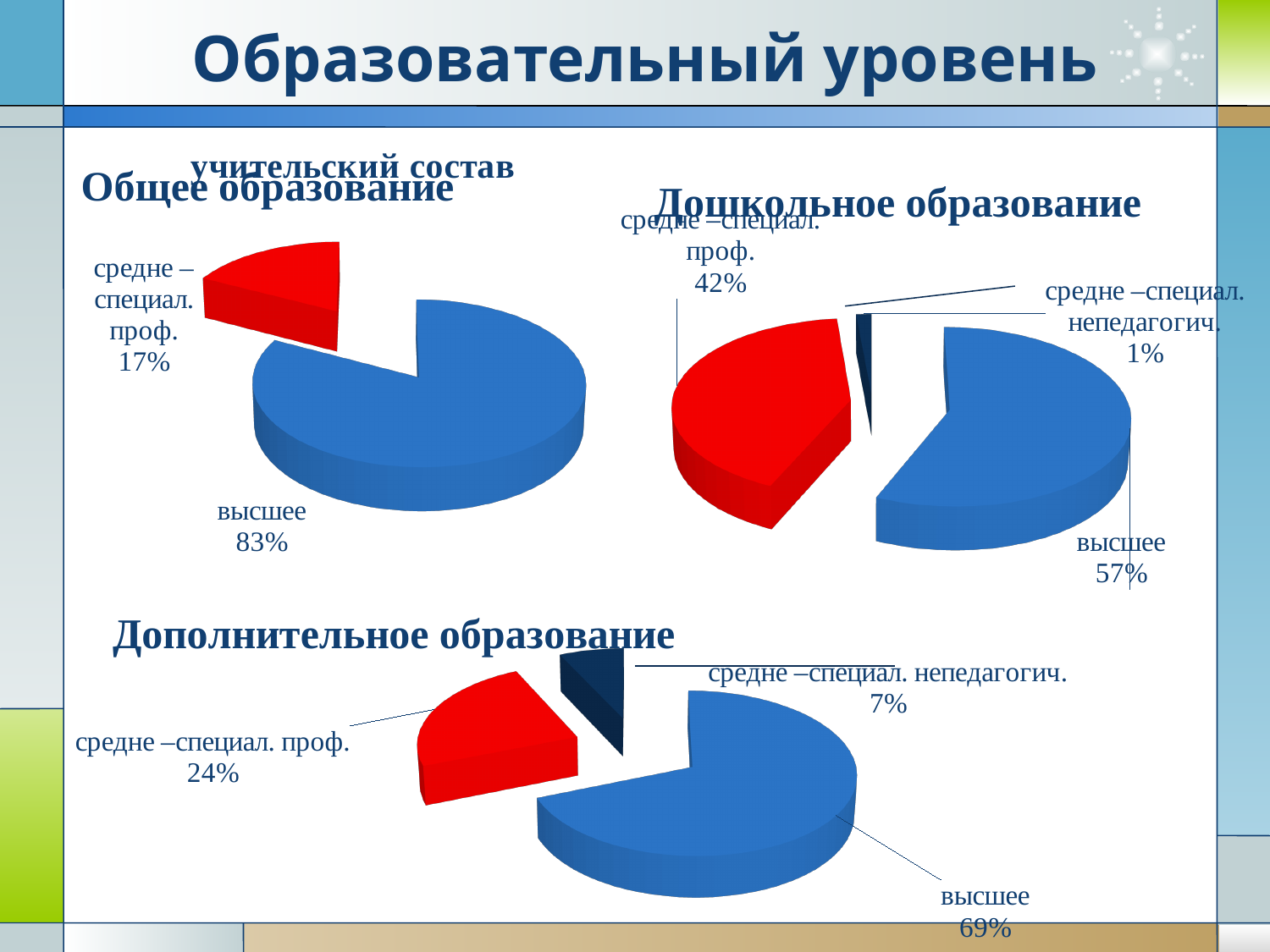
In the 'Дополнительное образование' chart, which is larger: the share for 'средне –специал. проф.' or for 'средне –специал. непедагогич.'? средне –специал. проф. In the 'Общее образование' chart, what share is labelled for 'средне – специал. проф.'? 17% In the 'Дошкольное образование' chart, what share is labelled for 'высшее'? 57% In the 'Общее образование' chart, what share is labelled for 'высшее'? 83% In the 'Дошкольное образование' chart, what share is labelled for 'средне –специал. непедагогич.'? 1% In the 'Дошкольное образование' chart, which category has the smallest share? средне –специал. непедагогич. In the 'Дополнительное образование' chart, which category has the largest share? высшее What type of chart is used for 'Общее образование'? Pie chart In the 'Дошкольное образование' chart, what is the difference between the shares for 'высшее' and 'средне –специал. проф.'? 15% How many slices does the 'Дошкольное образование' chart have? 3 In the 'Дополнительное образование' chart, what share is labelled for 'высшее'? 69% In the 'Дополнительное образование' chart, what share is labelled for 'средне –специал. проф.'? 24%